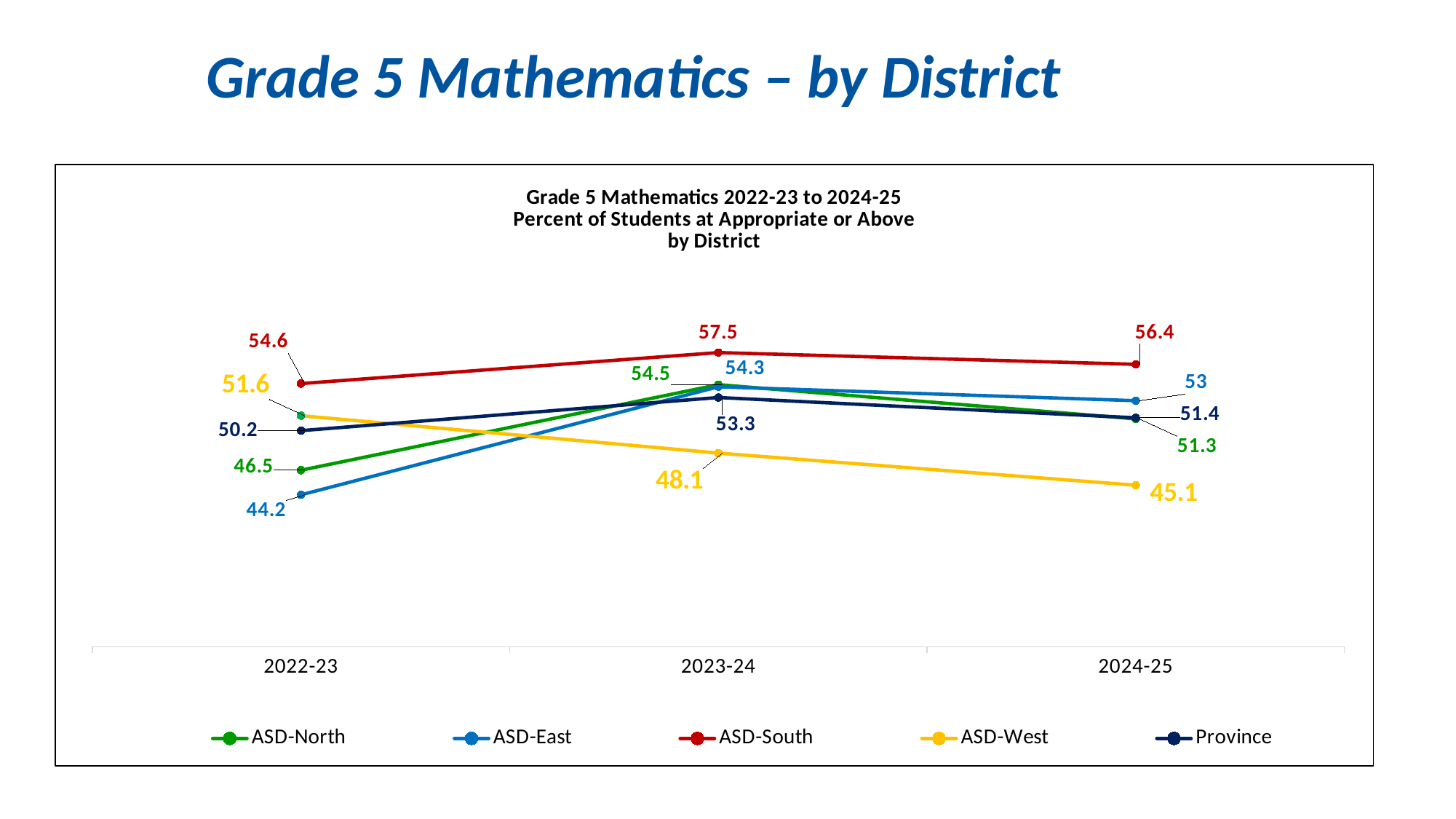
What is the difference between ASD-South and ASD-West in 2024-25? 11.3 What is the value for ASD-West in 2024-25? 45.1 Which is larger in 2023-24, ASD-North or ASD-West? ASD-North What is the value for Province in 2023-24? 53.3 What is the value for ASD-East in 2022-23? 44.2 How many series does the legend list? 5 Which district has the highest value in 2024-25? ASD-South How many school years are shown on the x axis? 3 Does the ASD-West line rise or fall from 2022-23 to 2024-25? Falls What is the value for ASD-South in 2023-24? 57.5 What kind of chart is shown? Line chart Which series has the lowest value in 2022-23? ASD-East